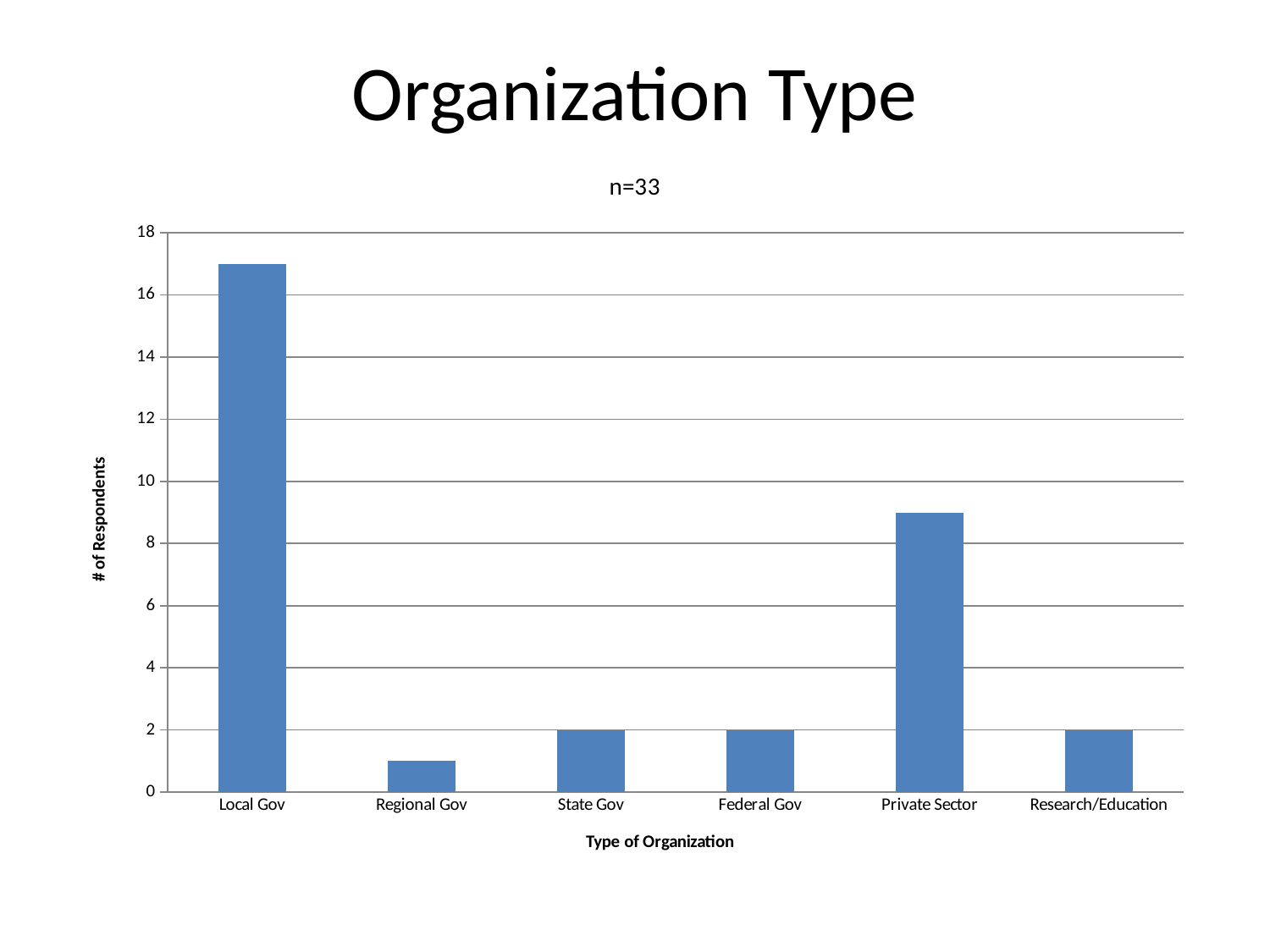
What is the label on the vertical axis of the chart? # of Respondents How many respondents are from Research/Education? 2 Which organization type has the highest number of respondents? Local Gov What kind of chart is shown on the slide? bar chart Is the value for Local Gov greater or less than 16? greater Which organization type has the lowest number of respondents? Regional Gov Is the value for Regional Gov greater or less than 2? less How many respondents are from State Gov? 2 How many respondents are from Federal Gov? 2 How many organization types are shown on the x axis? 6 Which has more respondents, Private Sector or Local Gov? Local Gov Is the value for Private Sector greater or less than 10? less